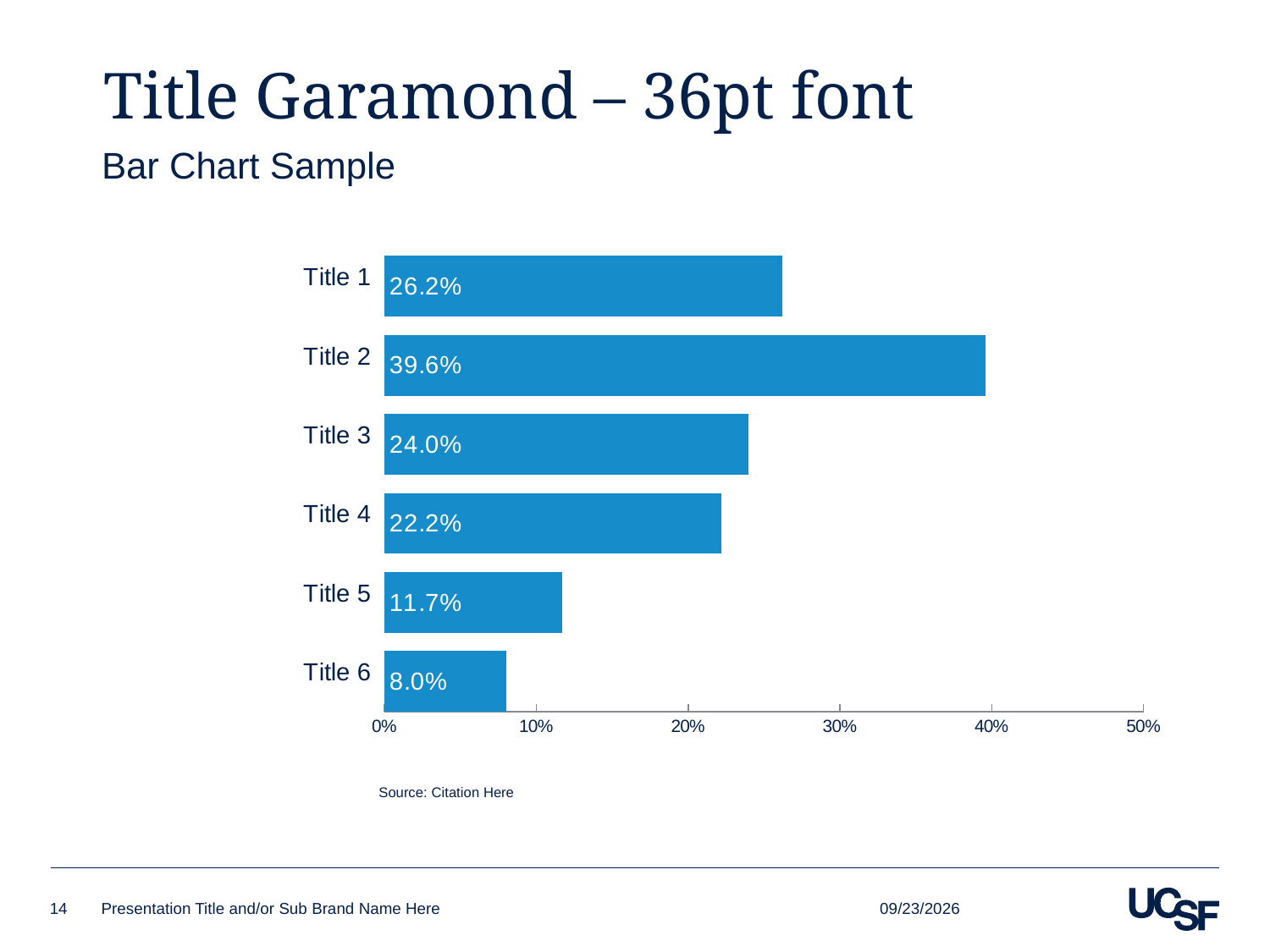
What is the difference between the values for Title 2 and Title 1? 13.4% Which is larger, the value for Title 1 or the value for Title 3? Title 1 Is the value for Title 4 greater or less than 20%? greater What is the source text shown below the chart? Source: Citation Here Which category has the highest value? Title 2 How many categories are shown in the chart? 6 What is the value for Title 5? 11.7% What is the difference between the values for Title 3 and Title 4? 1.8% What is the value for Title 2? 39.6% What is the value for Title 6? 8.0% Which category has the lowest value? Title 6 What kind of chart is shown on the slide? Bar chart